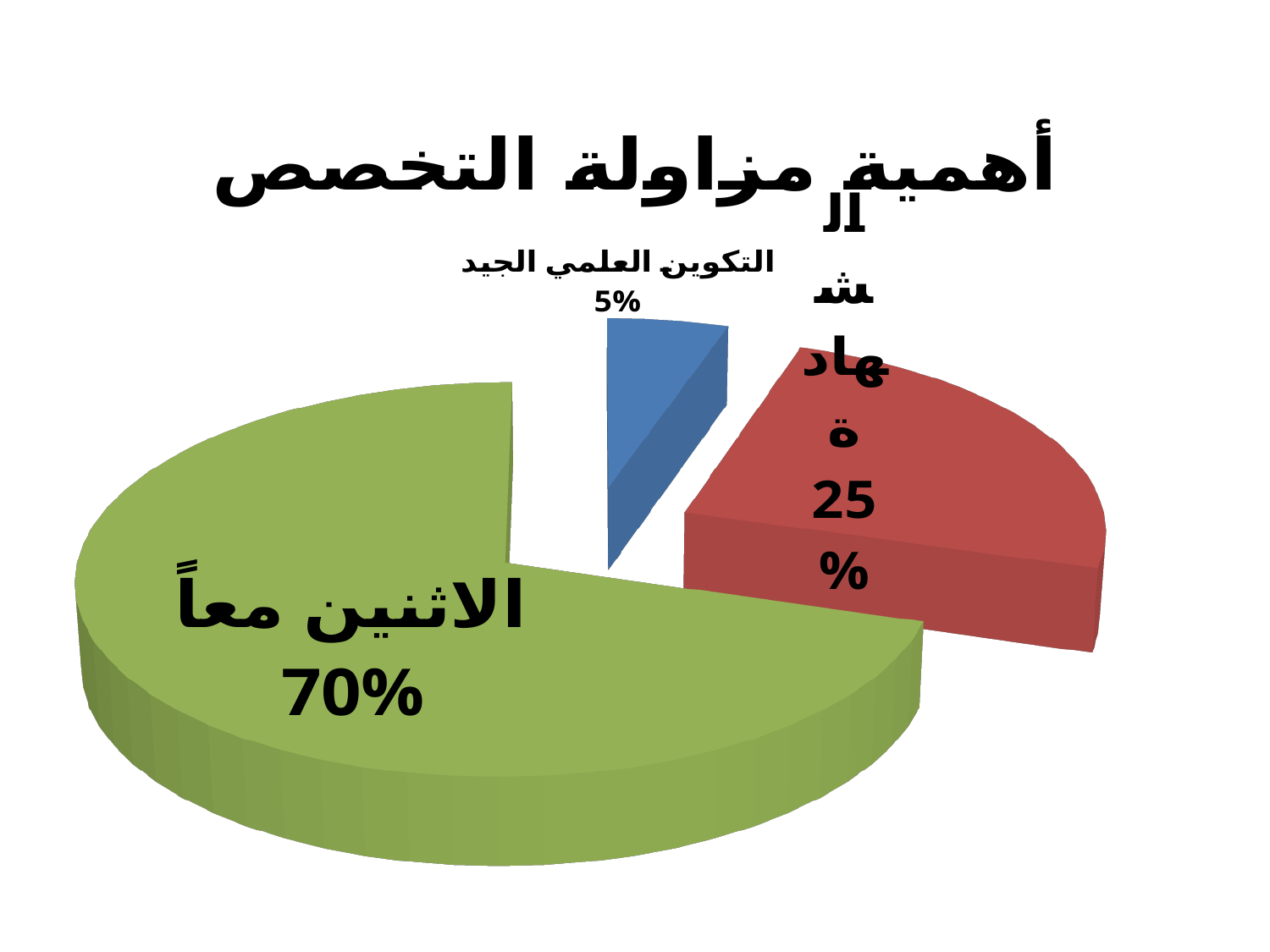
What is the difference in percentage points between الاثنين معاً and الشهادة? 45 Which category has the largest share of the pie? الاثنين معاً What is the difference in percentage points between الشهادة and التكوين العلمي الجيد? 20 What percentage is shown for الشهادة? 25% What kind of chart is shown on the slide? pie chart What is the title of the chart? أهمية مزاولة التخصص What colour is the slice for الاثنين معاً? green How many slices does the pie chart have? 3 Which is larger, the share for الشهادة or the share for التكوين العلمي الجيد? الشهادة What percentage is shown for الاثنين معاً? 70% Which category has the smallest share of the pie? التكوين العلمي الجيد What percentage is shown for التكوين العلمي الجيد? 5%